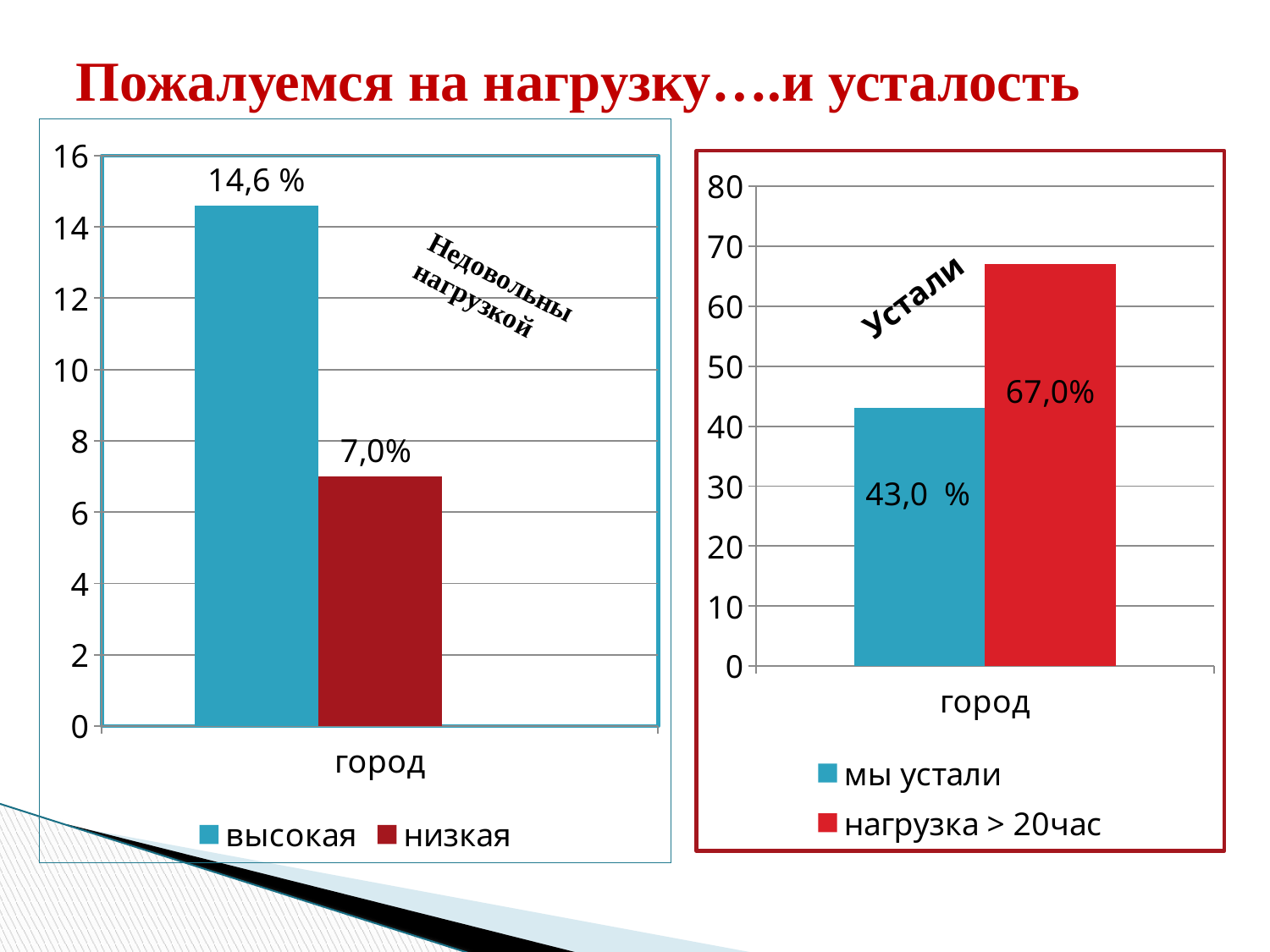
How many series does the legend of the left chart (Недовольны нагрузкой) list? 2 In the right chart (Устали), which series has the lower value? мы устали In the left chart (Недовольны нагрузкой), what is the value for the series высокая? 14,6 % In the right chart (Устали), what is the value for the series мы устали? 43,0 % In the left chart (Недовольны нагрузкой), what is the value for the series низкая? 7,0% In the right chart (Устали), is the value for мы устали greater or less than 50? less In the right chart (Устали), what is the value for the series нагрузка > 20час? 67,0% In the right chart (Устали), what is the difference between the values for нагрузка > 20час and мы устали? 24,0% In the left chart (Недовольны нагрузкой), what is the difference between the values for высокая and низкая? 7,6 % What kind of chart is the right chart (Устали)? bar chart In the left chart (Недовольны нагрузкой), which series has the higher value, высокая or низкая? высокая What is the category label on the x axis of the right chart (Устали)? город